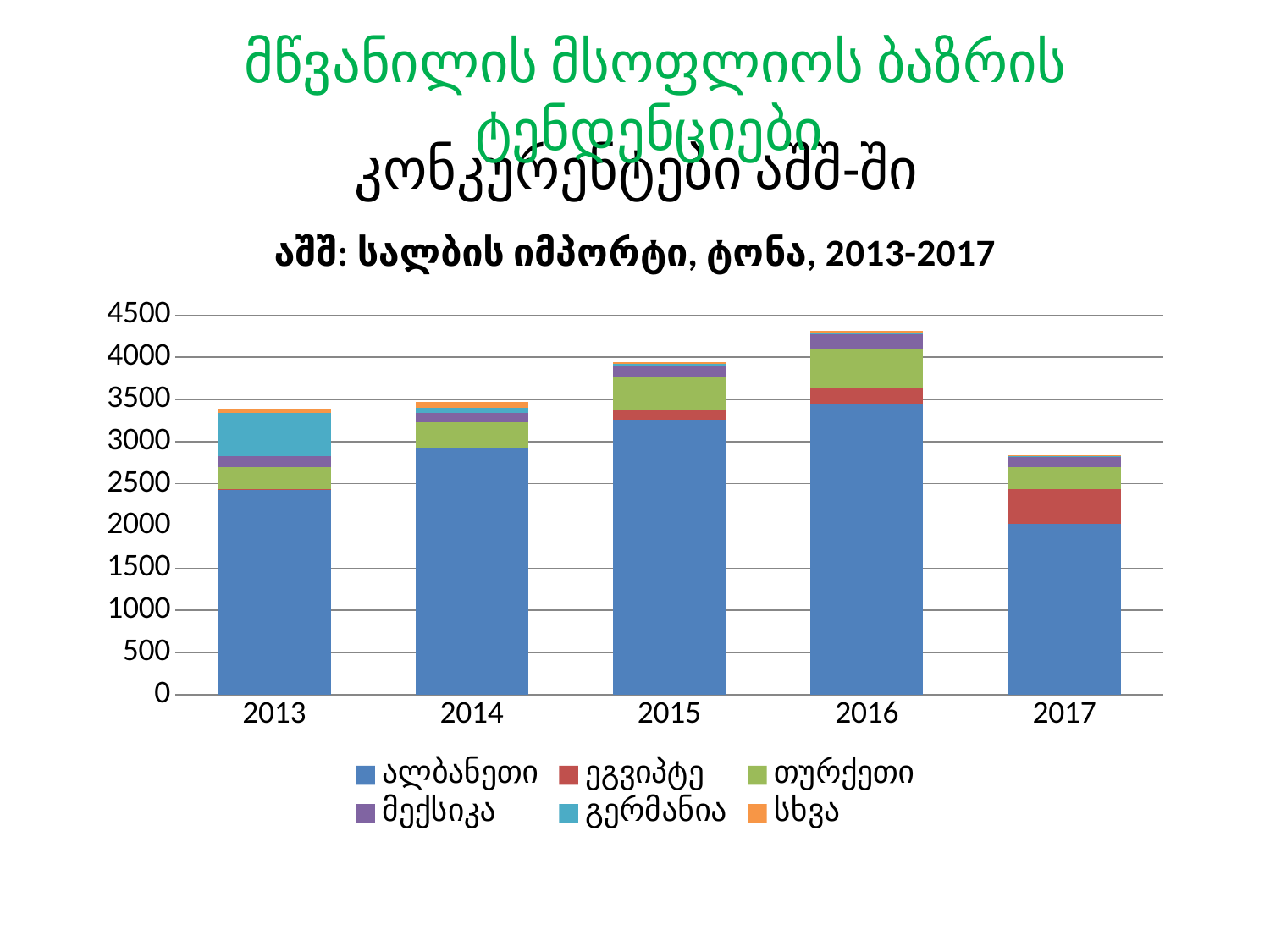
What kind of chart is shown on the slide? stacked bar chart How many years are shown on the x axis of the chart? 5 Which series is shown in blue at the bottom of each bar? ალბანეთი Which year has the highest total stacked bar? 2016 Is the total for 2013 greater or less than 3000? greater Which year has the lowest total stacked bar? 2017 Is the value for ალბანეთი in 2017 greater or less than 2500? less What is the title of the chart? აშშ: სალბის იმპორტი, ტონა, 2013-2017 Is the total for 2017 greater or less than 3000? less Which year has the larger total bar, 2015 or 2014? 2015 How many series does the chart's legend list? 6